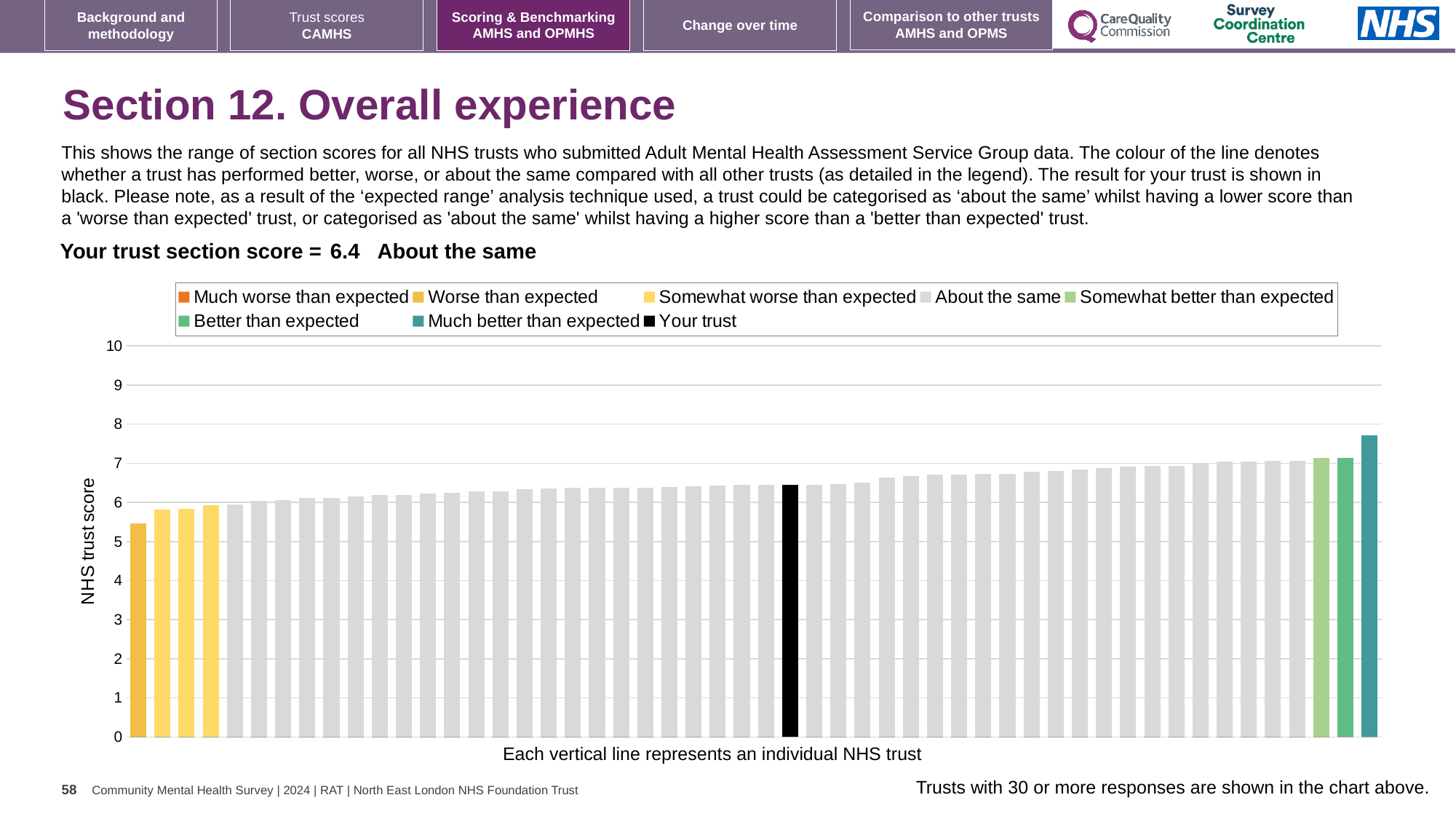
Do the bar values rise or fall from left to right along the x axis? rise How many bars are coloured as 'Much better than expected' (teal)? 1 What is the section score for your trust shown on the slide? 6.4 How many bars are coloured as 'Worse than expected' (yellow)? 1 Is the value of the shortest bar on the left greater or less than 5? greater What is the label of the y axis? NHS trust score What kind of chart is shown on the slide? bar chart How many entries does the chart legend list? 8 Is the value of the tallest bar (the 'Much better than expected' trust) greater or less than 7? greater Which legend category does the tallest bar belong to? Much better than expected Is the value of the black 'Your trust' bar greater or less than 7? less